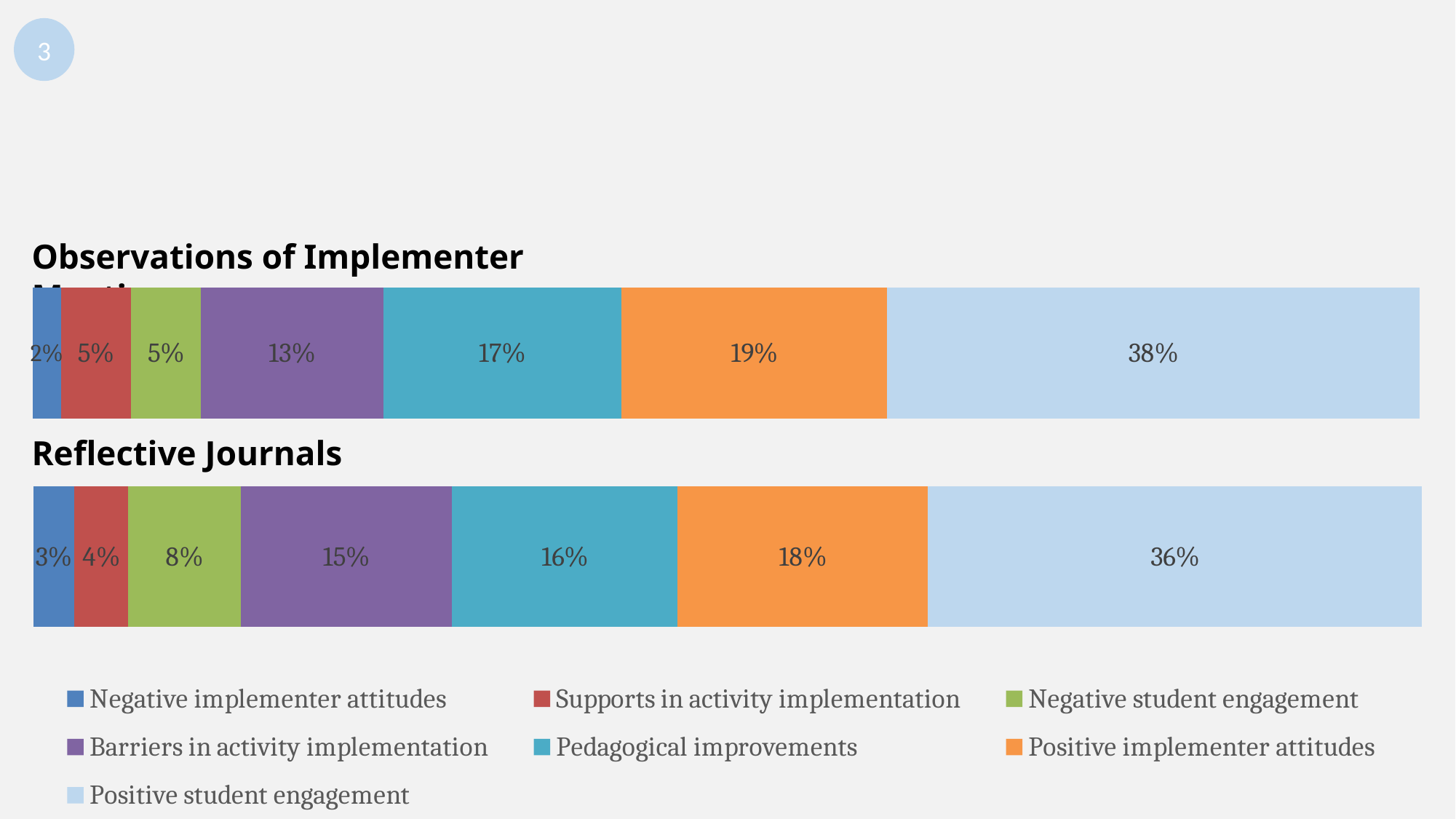
In the top bar (Observations of Implementer Meetings), what is the value for Pedagogical improvements? 17% In the Reflective Journals bar, which category has the largest share? Positive student engagement How much larger is Positive student engagement in the top bar (Observations of Implementer Meetings) than in the Reflective Journals bar? 2 percentage points In the top bar (Observations of Implementer Meetings), what is the value for Positive implementer attitudes? 19% What colour represents Positive implementer attitudes in the legend? Orange In the top bar (Observations of Implementer Meetings), which category has the smallest share? Negative implementer attitudes In the Reflective Journals bar, what is the value for Negative student engagement? 8% In the Reflective Journals bar, what is the value for Positive student engagement? 36% Is Barriers in activity implementation larger in the top bar (Observations of Implementer Meetings) or in the Reflective Journals bar? Reflective Journals How many series does the legend list? 7 What is the total of all segments in the Reflective Journals bar? 100% What kind of chart is shown on the slide? Stacked bar chart